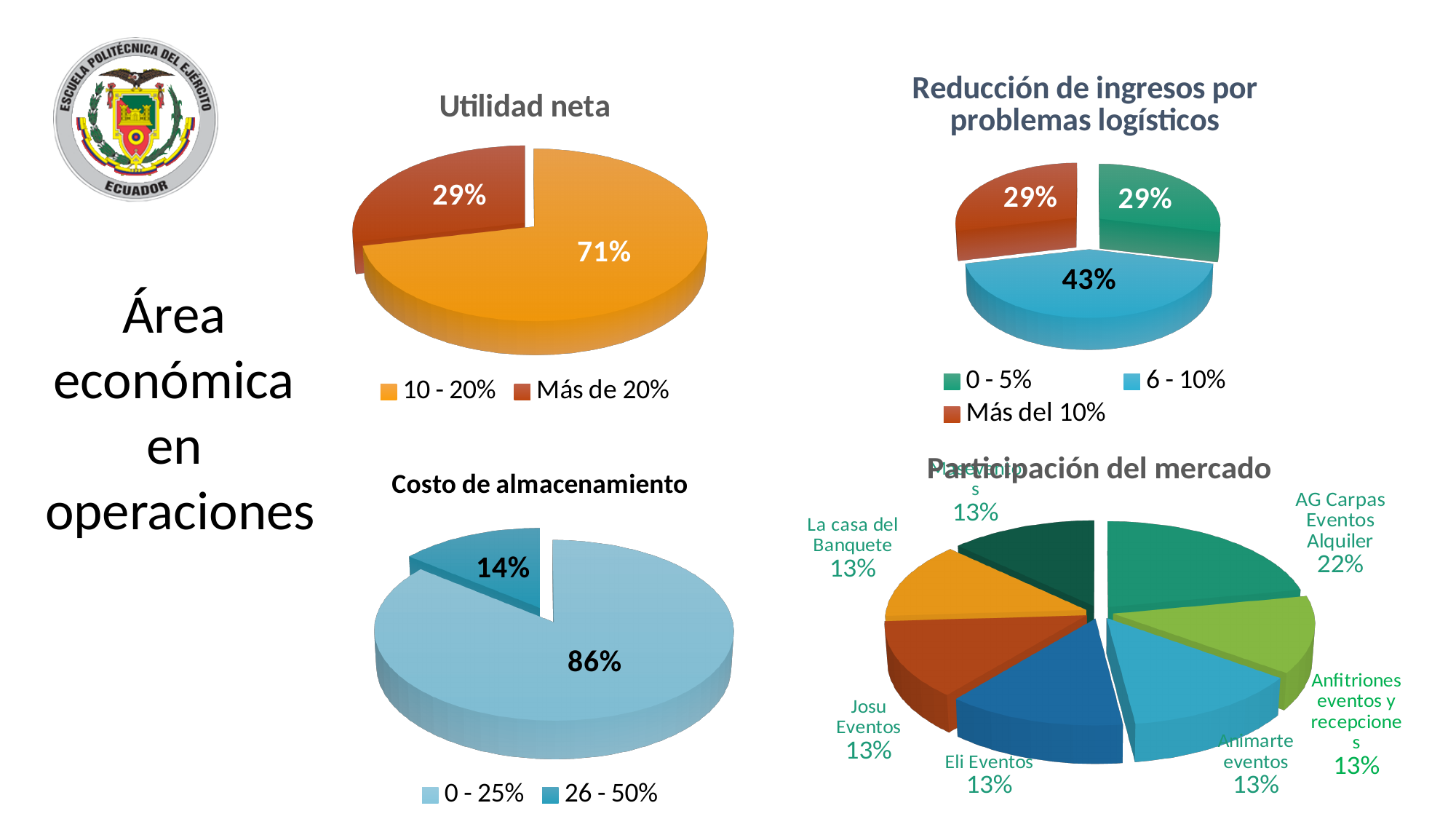
In the 'Participación del mercado' chart, which of 'AG Carpas Eventos Alquiler' or 'Eli Eventos' has the larger share? AG Carpas Eventos Alquiler How many categories does the legend of the 'Reducción de ingresos por problemas logísticos' chart list? 3 In the 'Participación del mercado' chart, what share is labelled for 'AG Carpas Eventos Alquiler'? 22% In the 'Reducción de ingresos por problemas logísticos' chart, what is the difference between the '6 - 10%' share and the '0 - 5%' share? 14 percentage points In the 'Costo de almacenamiento' chart, what share is labelled for '0 - 25%'? 86% In the 'Costo de almacenamiento' chart, what is the difference between the '0 - 25%' share and the '26 - 50%' share? 72 percentage points In the 'Reducción de ingresos por problemas logísticos' chart, which category has the largest share? 6 - 10% What kind of chart is 'Utilidad neta'? Pie chart In the 'Utilidad neta' chart, what share is labelled for the 'Más de 20%' slice? 29% In the 'Utilidad neta' chart, what share is labelled for the '10 - 20%' slice? 71% In the 'Costo de almacenamiento' chart, which category has the smallest share? 26 - 50% In the 'Reducción de ingresos por problemas logísticos' chart, what share is labelled for '6 - 10%'? 43%